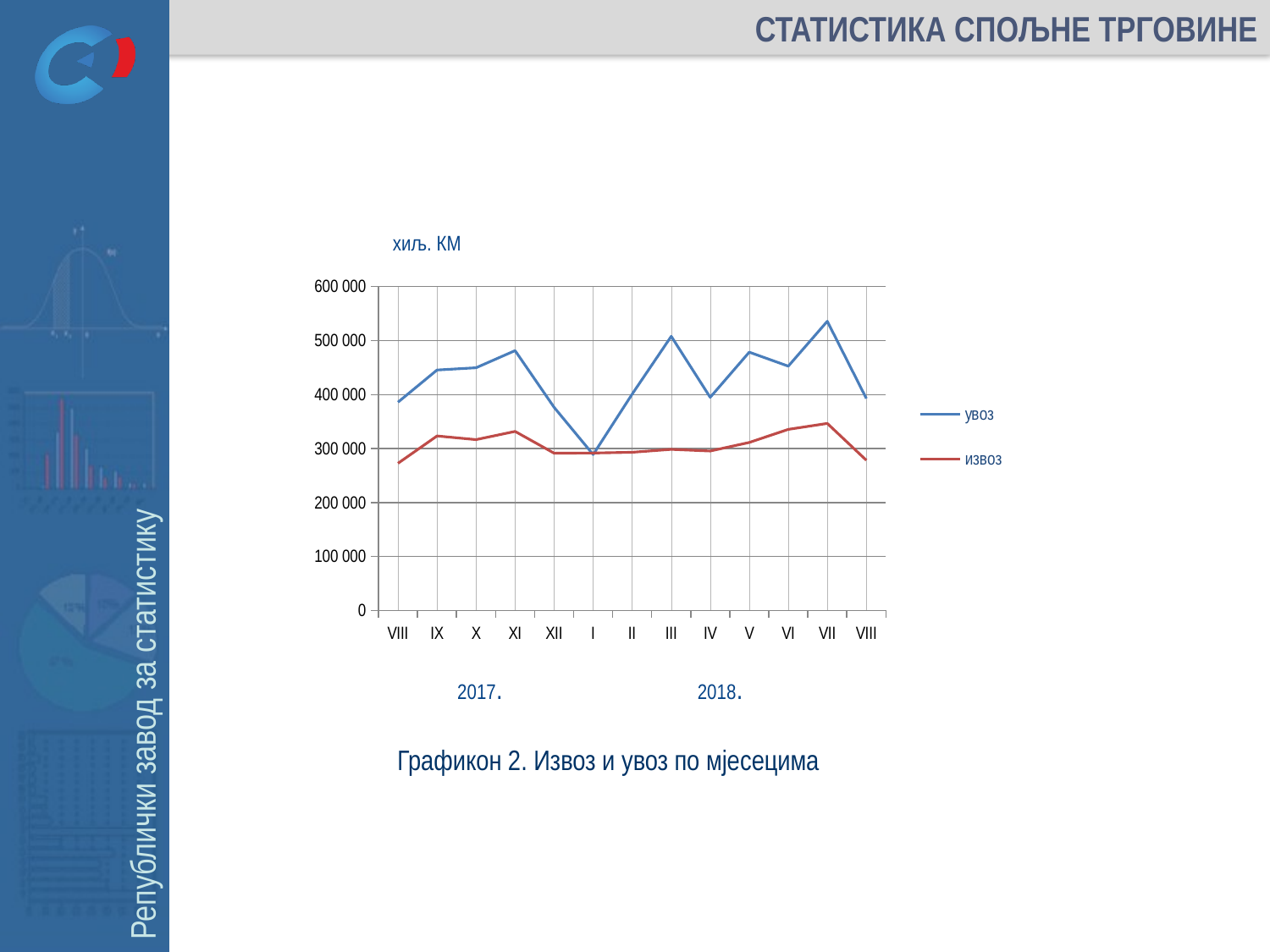
Which month has the highest value for увоз? VII 2018 How many months are plotted along the x axis? 13 Which month has the lowest value for увоз? I 2018 Is the value for увоз in I 2018 greater or less than 400 000? less Is the value for извоз in VIII 2017 greater or less than 300 000? less What is the title of the chart? Графикон 2. Извоз и увоз по мјесецима Is the value for извоз in XI 2017 greater or less than 300 000? greater In VII 2018, which is larger, увоз or извоз? увоз What kind of chart is shown on the slide? line chart How many series does the legend list? 2 Which month has the highest value for извоз? VII 2018